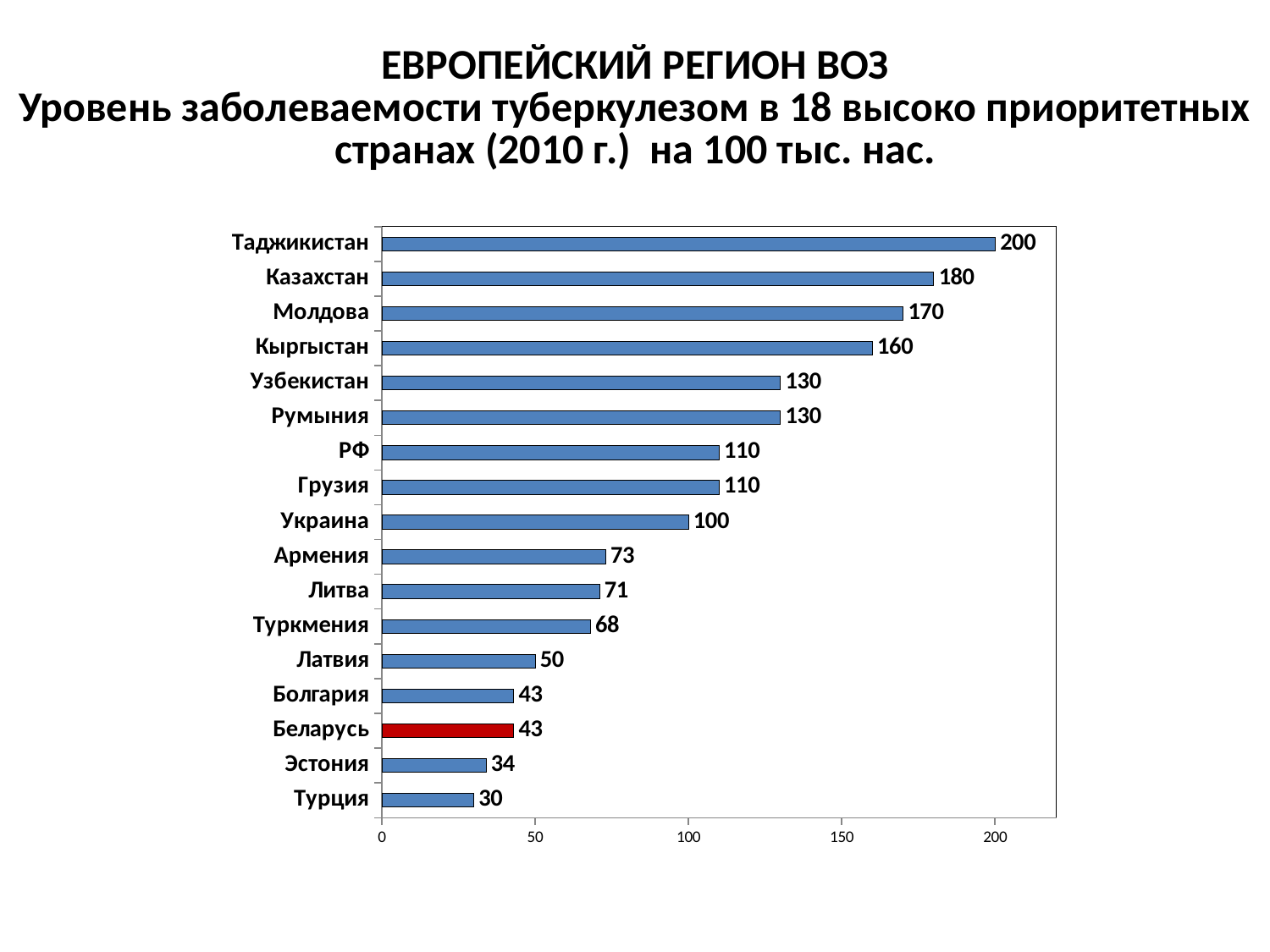
What is the difference between the values for Эстония and Турция? 4 What value is shown for Туркмения? 68 What value is shown for Беларусь? 43 Which country's bar is coloured red instead of blue? Беларусь What is the difference between the values for Казахстан and Украина? 80 Which country has the lowest value on the chart? Турция How many countries are plotted on the chart? 17 What kind of chart is shown on the slide? bar chart Is the value for Кыргыстан greater or less than 150? greater Which country has the highest value on the chart? Таджикистан What is the tuberculosis incidence value shown for Таджикистан? 200 Which has a larger value, Армения or Латвия? Армения